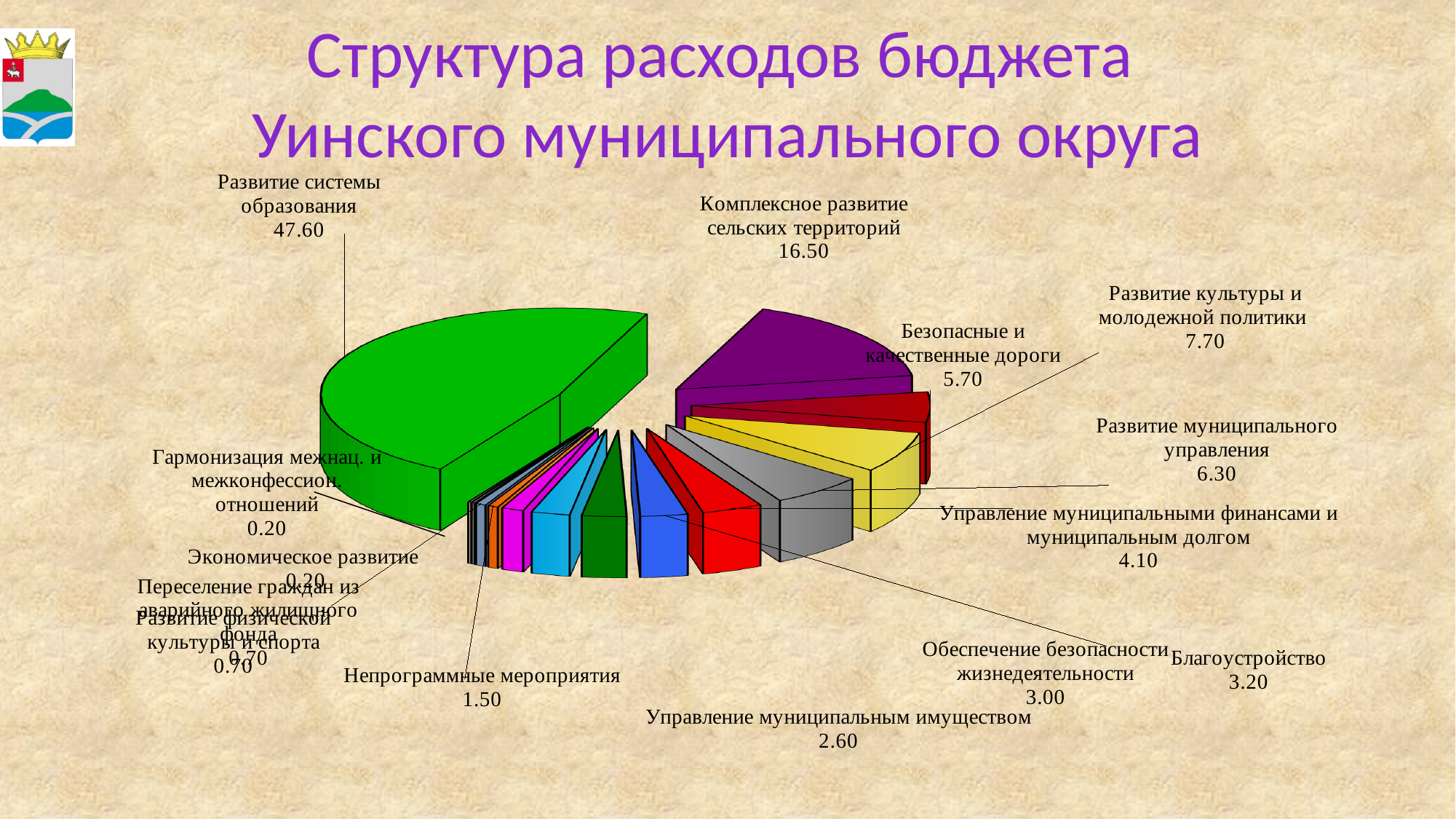
Which category has the largest slice of the pie? Развитие системы образования What is the title of the slide containing the chart? Структура расходов бюджета Уинского муниципального округа What is the value for Благоустройство? 3.20 What is the value for Управление муниципальными финансами и муниципальным долгом? 4.10 What is the value for Комплексное развитие сельских территорий? 16.50 What is the value for Непрограммные мероприятия? 1.50 What is the value for Развитие системы образования? 47.60 What type of chart is shown on the slide? Pie chart What is the difference between the values for Развитие культуры и молодежной политики and Безопасные и качественные дороги? 2.00 Which is larger: Развитие муниципального управления or Безопасные и качественные дороги? Развитие муниципального управления What is the difference between the values for Развитие системы образования and Комплексное развитие сельских территорий? 31.10 Which is larger: Обеспечение безопасности жизнедеятельности or Управление муниципальным имуществом? Обеспечение безопасности жизнедеятельности